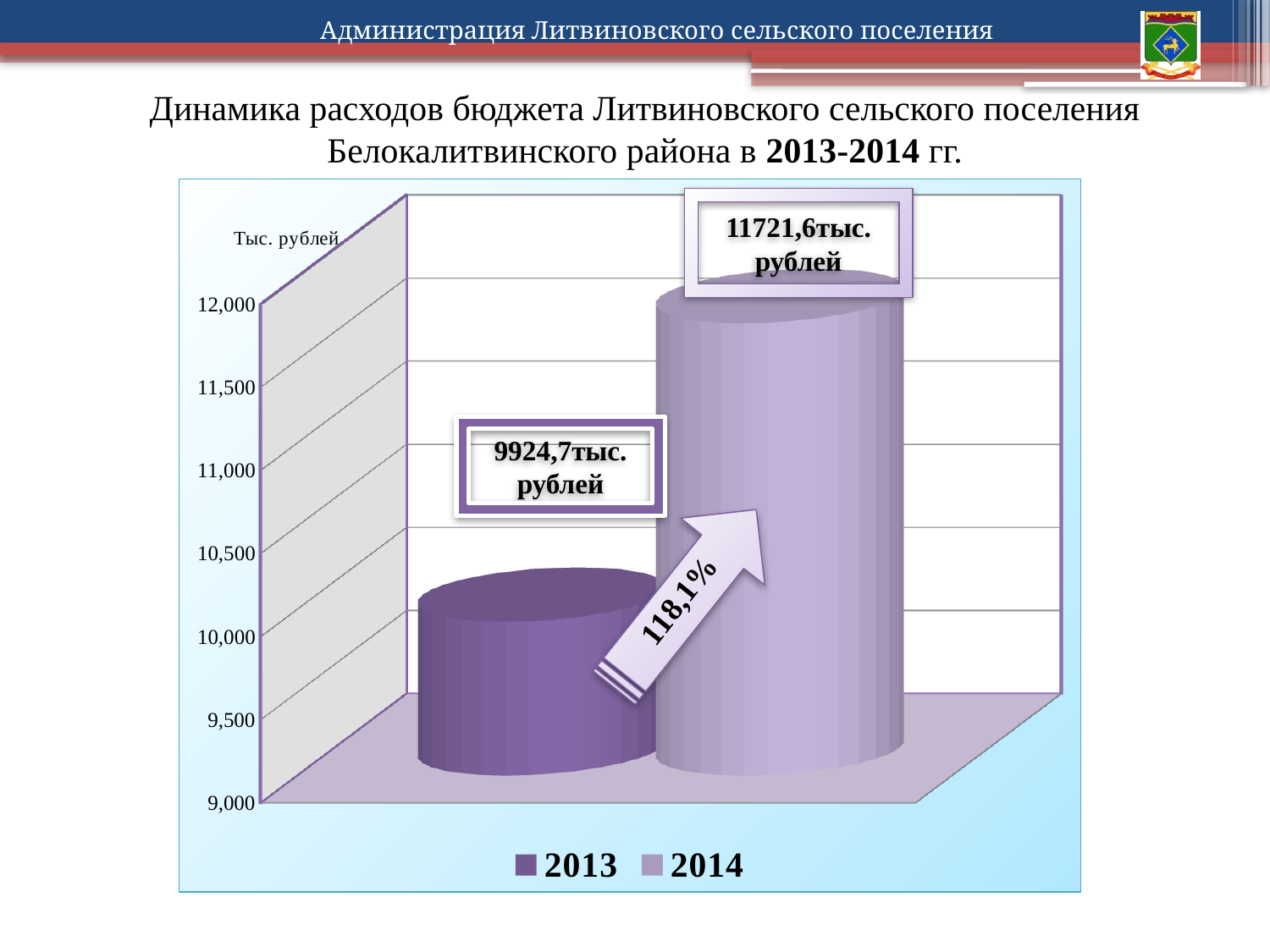
Which year has the higher budget expenditure? 2014 What unit label is shown at the top of the vertical axis? Тыс. рублей Is the value for 2014 greater or less than 11,500? greater By how much did budget expenditure in 2014 exceed that of 2013? 1796,9 тыс. рублей What is the budget expenditure value shown for 2014? 11721,6 тыс. рублей Is the value for 2013 greater or less than 10,000? less What kind of chart is shown on the slide? bar chart What is the budget expenditure value shown for 2013? 9924,7 тыс. рублей What percentage is written on the arrow between the two bars? 118,1% How many bars are plotted on the chart? 2 Which year has the lower budget expenditure? 2013 How many entries does the legend list? 2